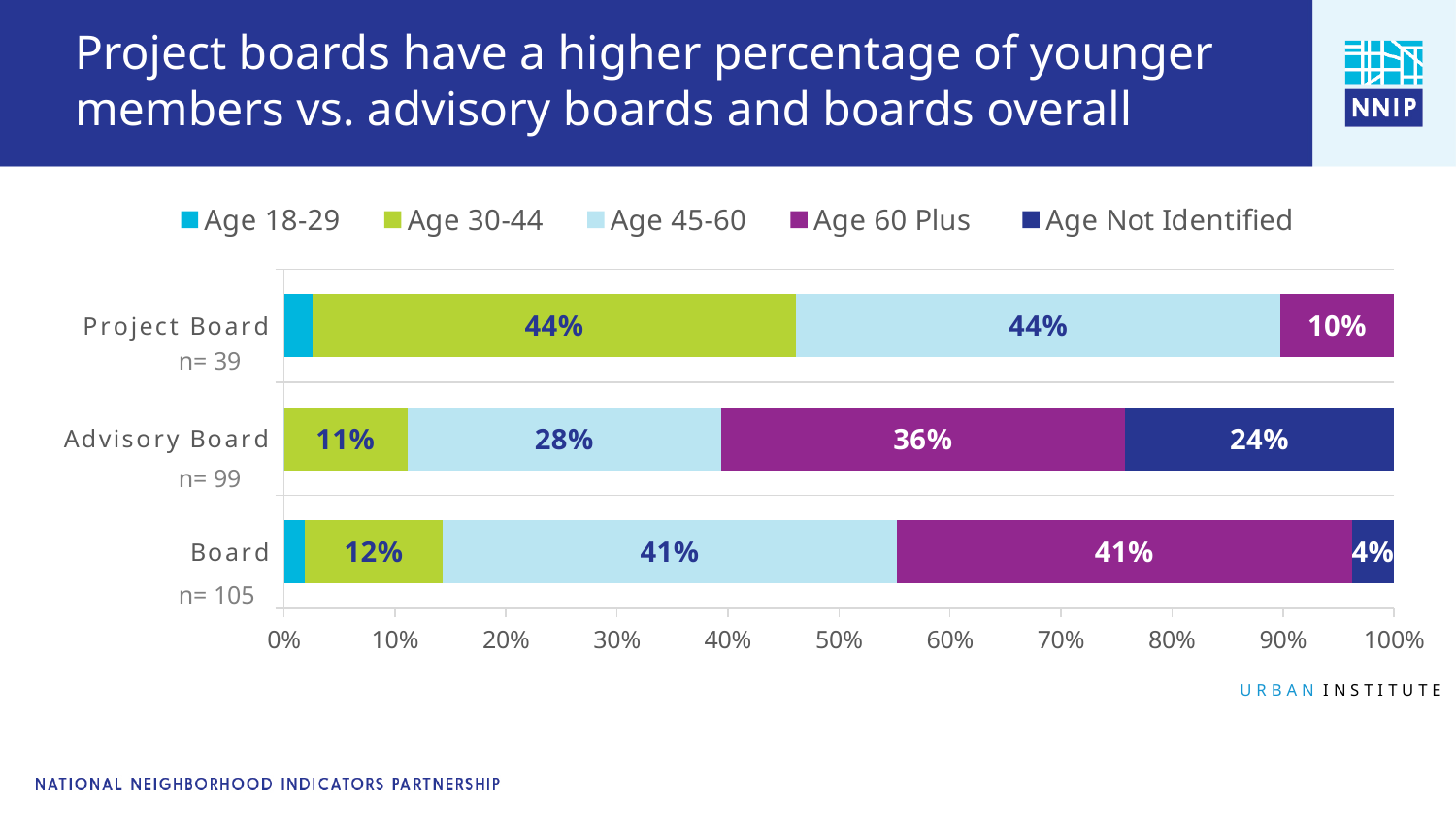
What is the sample size (n) shown for the Advisory Board? n= 99 What is the difference in percentage points between the Age 60 Plus and Age 30-44 shares for the Advisory Board? 25 percentage points What percentage of Project Board members are Age 30-44? 44% What kind of chart is shown on the slide? Stacked bar chart Which is larger: the Age 60 Plus share for the Board or for the Project Board? Board What percentage of Advisory Board members are Age 45-60? 28% How many boards are shown on the chart? 3 What percentage of Advisory Board members are Age 60 Plus? 36% How many age groups does the legend list? 5 Which board has the highest percentage of members Age 30-44? Project Board Which board has the lowest percentage of members Age 45-60? Advisory Board What percentage of Board members have Age Not Identified? 4%